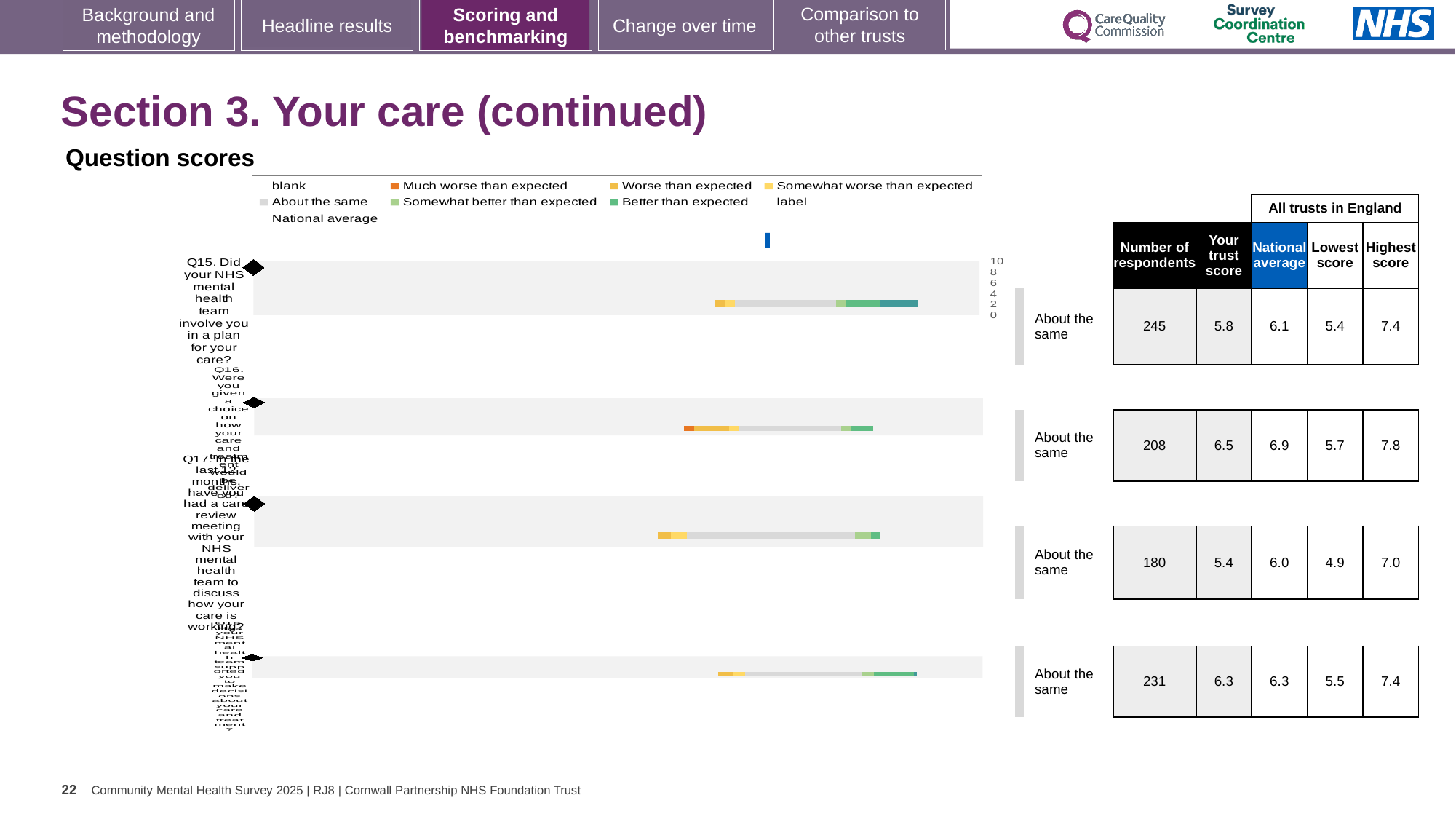
What is the difference between the highest score and the lowest score for Q15? 2.0 Which of Q15, Q16 and Q17 has the most respondents? Q15 What kind of chart is used to show the question scores on this slide? bar chart Which of Q15, Q16 and Q17 has the fewest respondents? Q17 In the chart legend, what colour represents 'Much worse than expected'? orange What is the lowest score across all trusts in England for Q17? 4.9 Which is larger, the trust score for Q15 or the trust score for Q16? Q16 What is the number of respondents for Q15 (Did your NHS mental health team involve you in a plan for your care?)? 245 What is the trust score for Q16 (Were you given a choice on how your care and treatment would be delivered)? 6.5 What is the national average for Q17 (In the last 12 months, have you had a care review meeting)? 6.0 What is the highest score across all trusts in England for Q16? 7.8 How many question rows (bars) are plotted in the question scores chart? 4